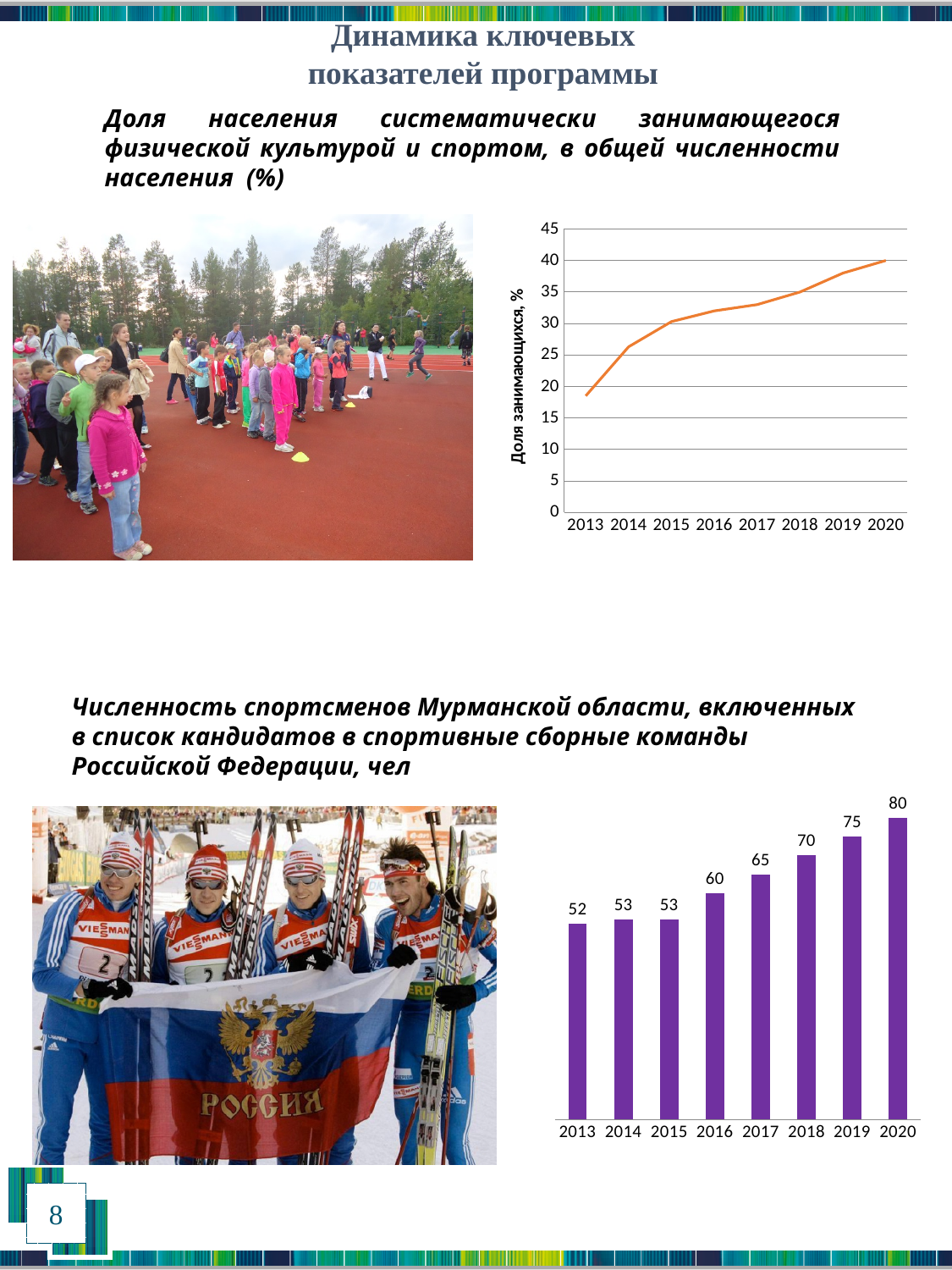
In the top line chart, do the values rise or fall from 2013 to 2020? rise In the top line chart, is the value for 2013 greater or less than 20? less In the top line chart, is the value for 2017 greater or less than 30? greater In the bottom bar chart, which is larger, the value for 2018 or the value for 2017? 2018 How many years are shown on the x axis of the top line chart? 8 In the top line chart, is the value for 2020 greater or less than 35? greater In the bottom bar chart, which year has the highest value? 2020 In the bottom bar chart, what is the difference between the values for 2020 and 2013? 28 What type of chart is the bottom chart on the slide? bar chart In the bottom bar chart, which year has the lowest value? 2013 What type of chart is the top chart on the slide? line chart In the bottom bar chart, what is the value for 2016? 60